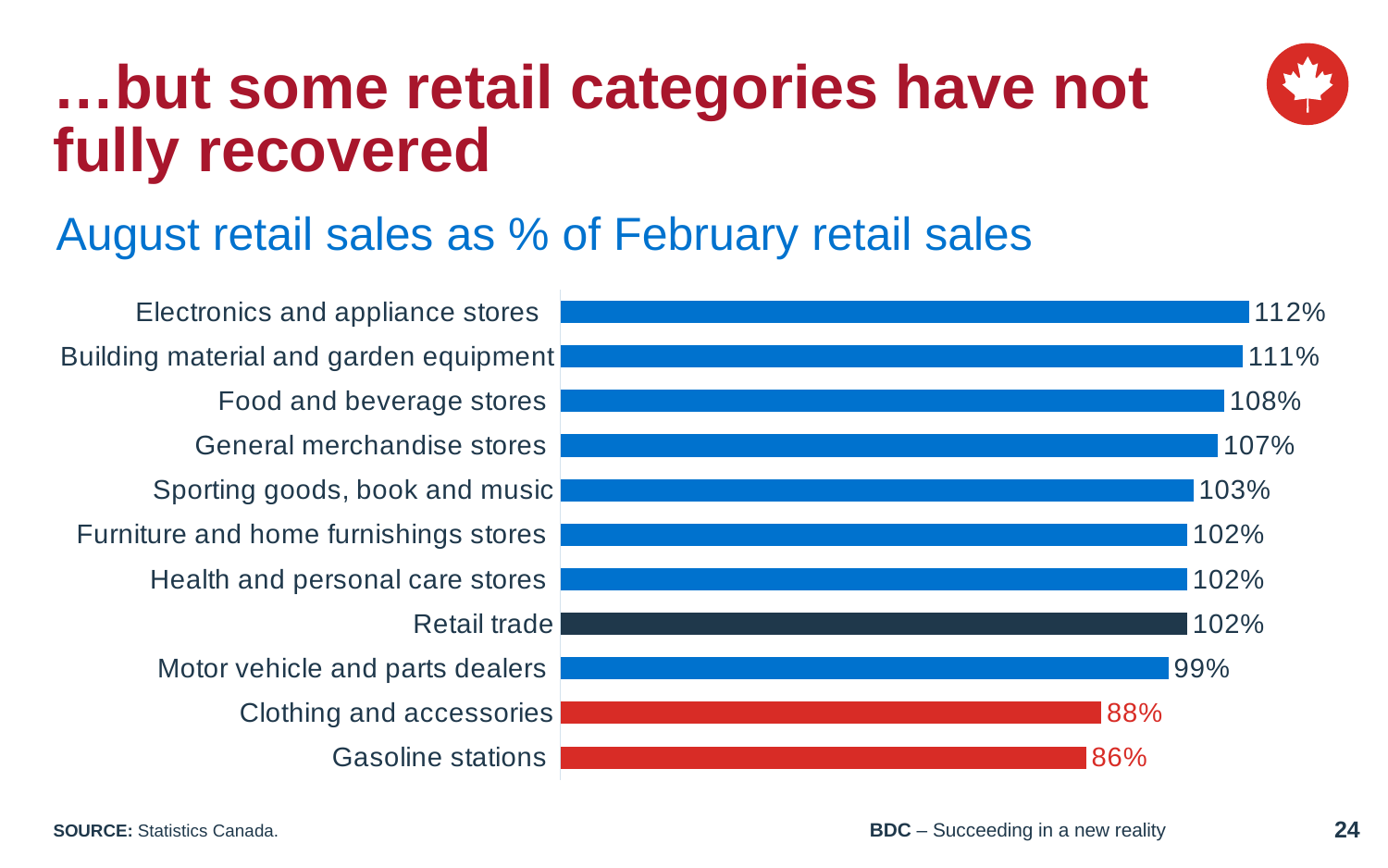
What is the value for Gasoline stations? 86% Which category has the lowest value? Gasoline stations What is the difference between the values for Electronics and appliance stores and Gasoline stations? 26% Which category has the highest value? Electronics and appliance stores What is the value for Motor vehicle and parts dealers? 99% Which is larger, the value for Food and beverage stores or the value for General merchandise stores? Food and beverage stores What is the difference between the values for Clothing and accessories and Gasoline stations? 2% What is the value for Electronics and appliance stores? 112% What is the value for Retail trade? 102% What kind of chart is shown on the slide? Bar chart How many categories are shown in the chart? 11 Which categories are shown with red bars? Clothing and accessories and Gasoline stations